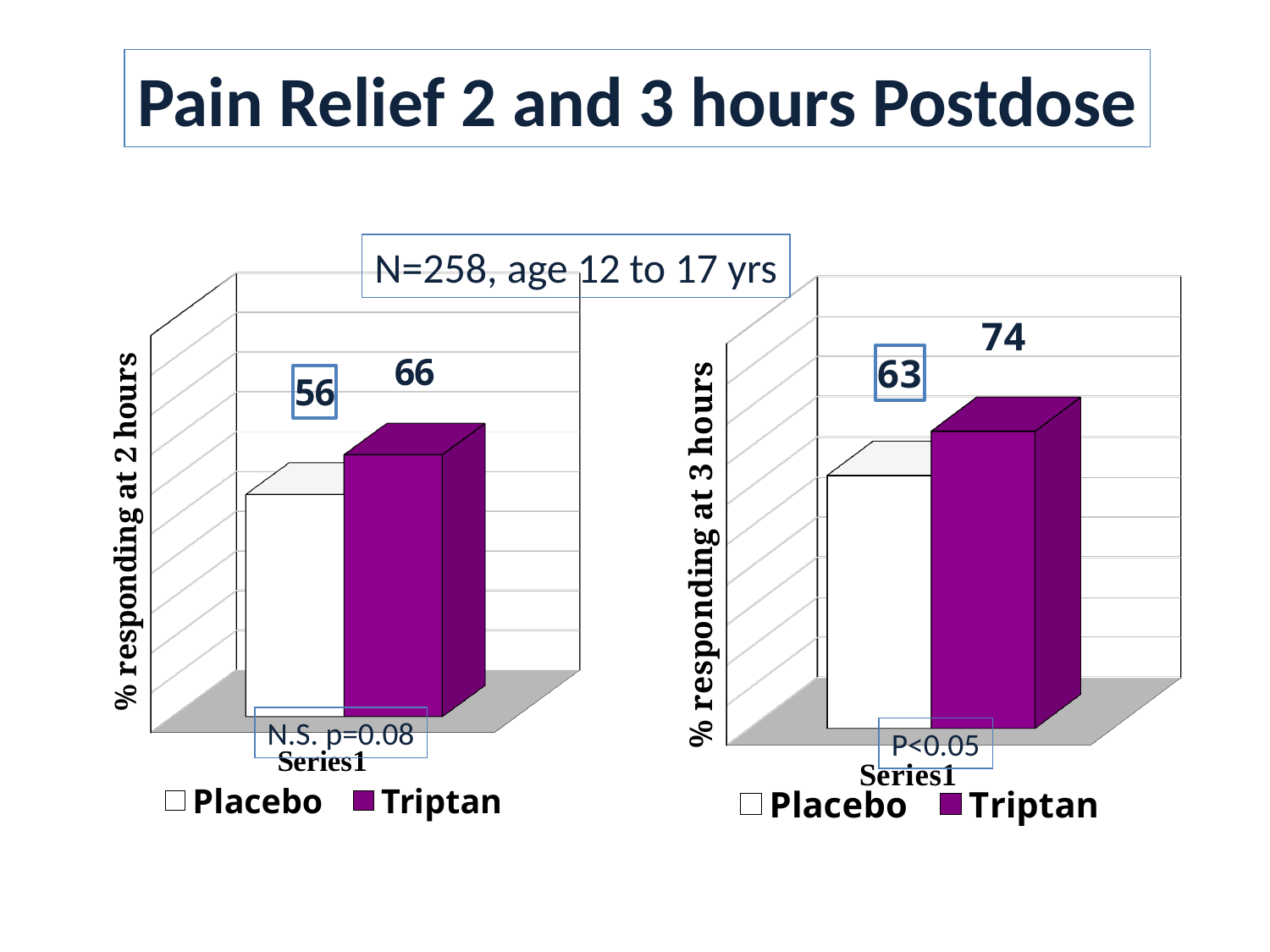
In the left chart (% responding at 2 hours), what is the difference between the Triptan and Placebo values? 10 In the right chart (% responding at 3 hours), which series has the lower value? Placebo In the left chart (% responding at 2 hours), what is the value for Placebo? 56 Is the Triptan value in the right chart (3 hours) larger or smaller than the Triptan value in the left chart (2 hours)? larger In the left chart (% responding at 2 hours), which series has the higher value? Triptan In the right chart (% responding at 3 hours), what is the difference between the Triptan and Placebo values? 11 How many series does the legend of the left chart list? 2 In the right chart (% responding at 3 hours), what is the value for Placebo? 63 What kind of chart is the right chart (% responding at 3 hours)? bar chart In the left chart (% responding at 2 hours), what is the value for Triptan? 66 In the right chart (% responding at 3 hours), what is the value for Triptan? 74 What colour are the Triptan bars in both charts? purple